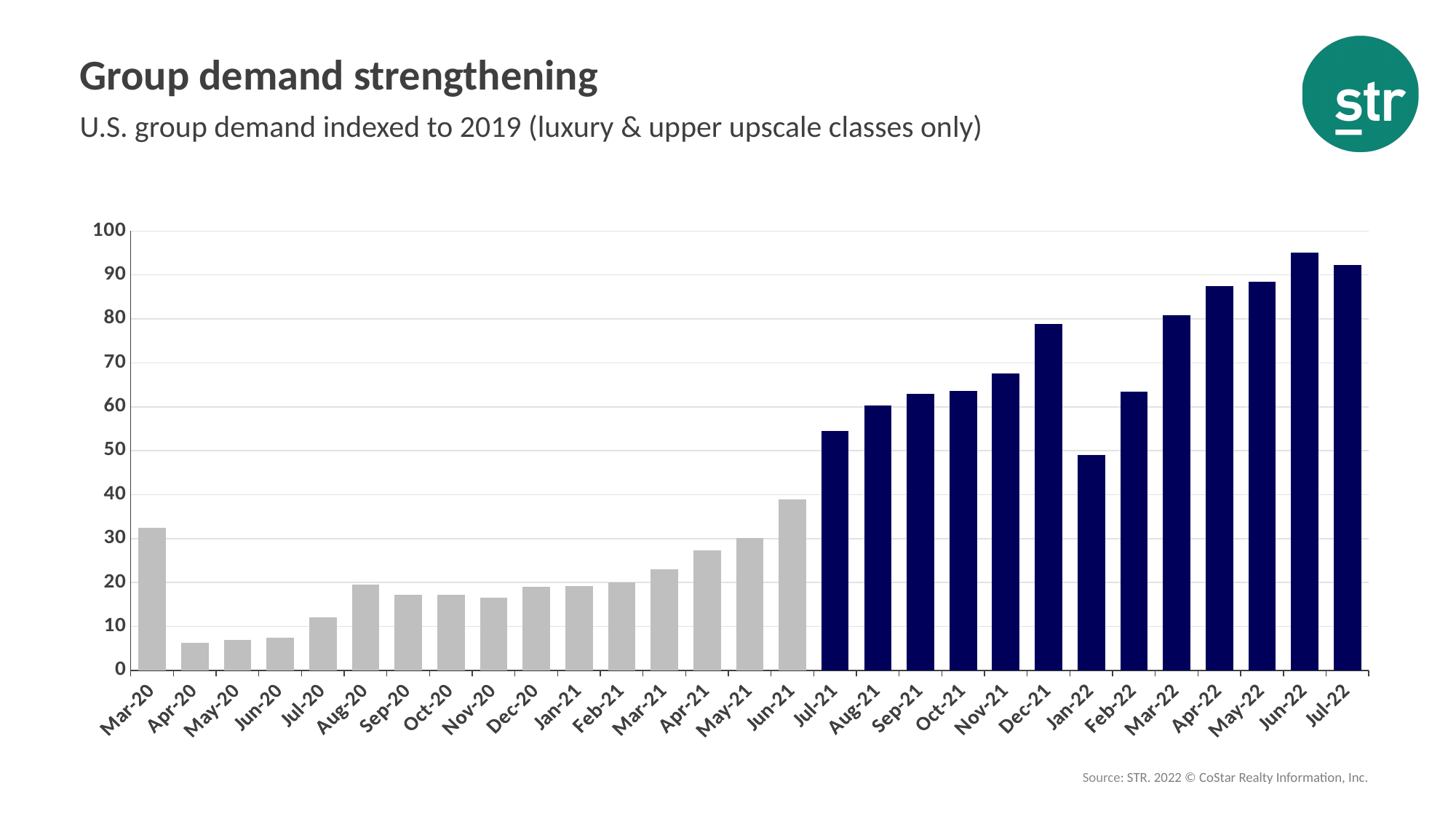
Is the value for Jul-20 greater or less than 10? greater What is the title of the slide? Group demand strengthening Is the value for Nov-21 greater or less than 60? greater Is the value for Jul-21 greater or less than 50? greater Which month has the highest group demand index? Jun-22 Which is larger, the value for Dec-21 or the value for Jan-22? Dec-21 Which is larger, the value for Mar-20 or the value for Apr-20? Mar-20 Do the values rise or fall from Mar-22 to Jun-22? Rise What kind of chart is shown on the slide? Bar chart How many months are plotted along the x axis? 29